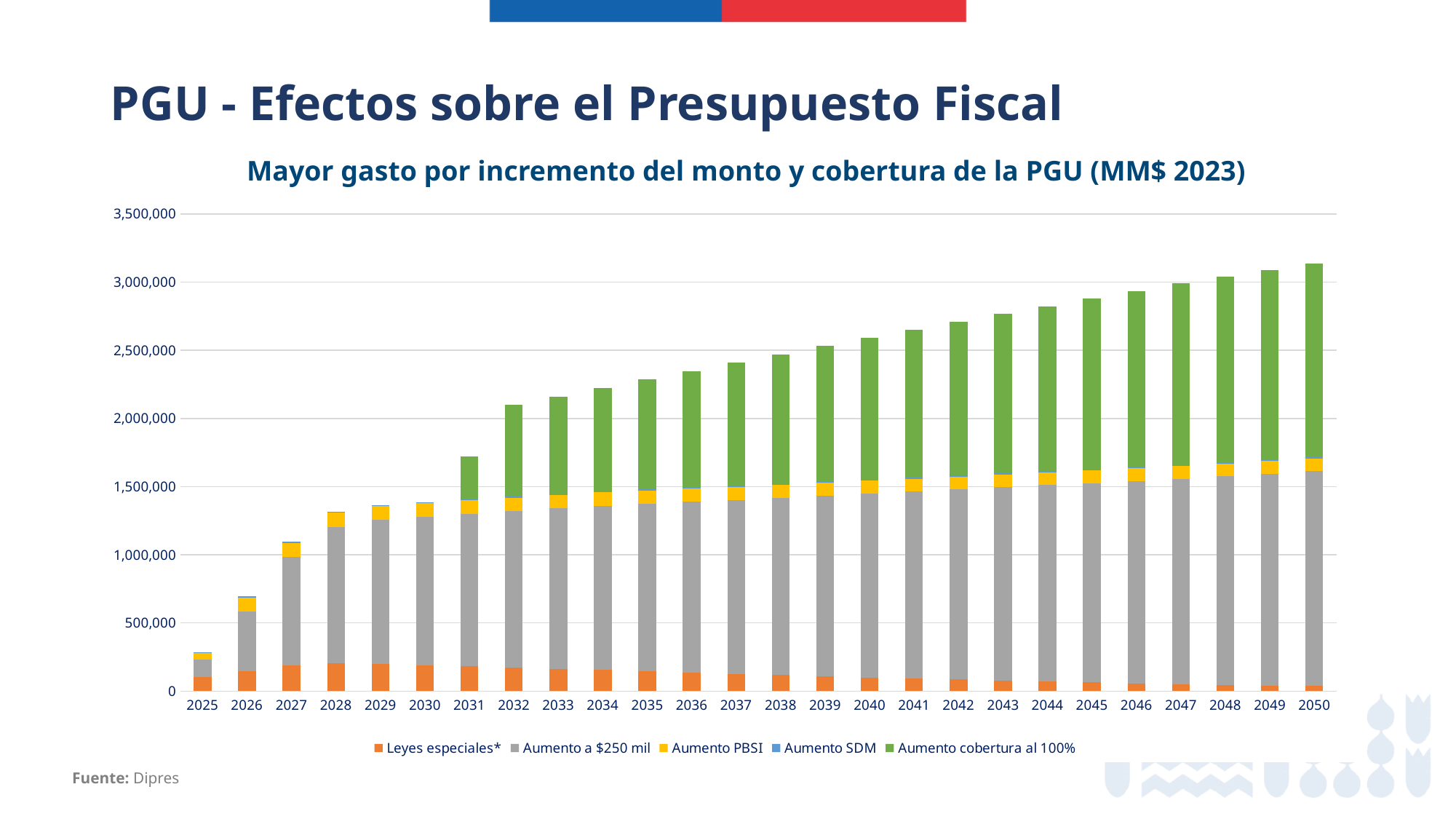
What kind of chart is shown on the slide? Stacked bar chart How many series does the legend list? 5 Is the total bar for 2050 greater or less than 3,000,000? greater Do the total bar heights rise or fall from 2025 to 2050? Rise Which year has the lowest total bar? 2025 How many years are shown on the x axis of the chart? 26 Is the total bar for 2031 greater or less than 2,000,000? less Is the total bar for 2045 greater or less than 3,000,000? less Which series is shown in green in the legend? Aumento cobertura al 100% Which year has the highest total bar? 2050 Which is larger, the total bar for 2040 or the total bar for 2030? 2040